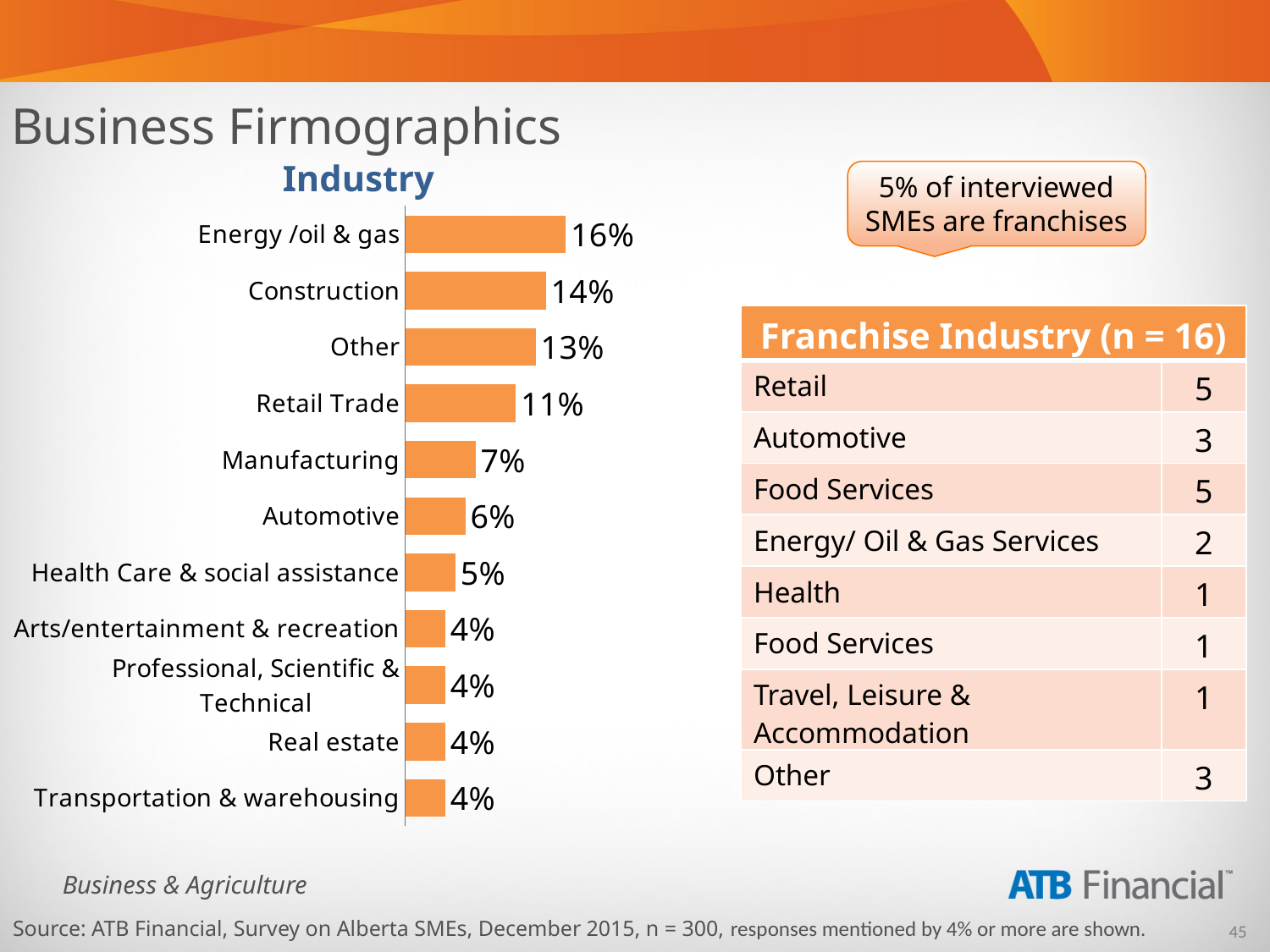
What is the value for Manufacturing in the Industry chart? 7% Which industry has the highest value in the Industry chart? Energy /oil & gas What is the difference between the values for Retail Trade and Automotive in the Industry chart? 5% What is the value for Construction in the Industry chart? 14% What is the value for Retail Trade in the Industry chart? 11% What is the difference between the values for Energy /oil & gas and Construction in the Industry chart? 2% What is the title of the chart on the slide? Industry Which is larger in the Industry chart, Other or Manufacturing? Other What is the value for Energy /oil & gas in the Industry chart? 16% What is the value for Health Care & social assistance in the Industry chart? 5% What type of chart is the Industry chart? Bar chart How many industry categories are shown in the Industry chart? 11